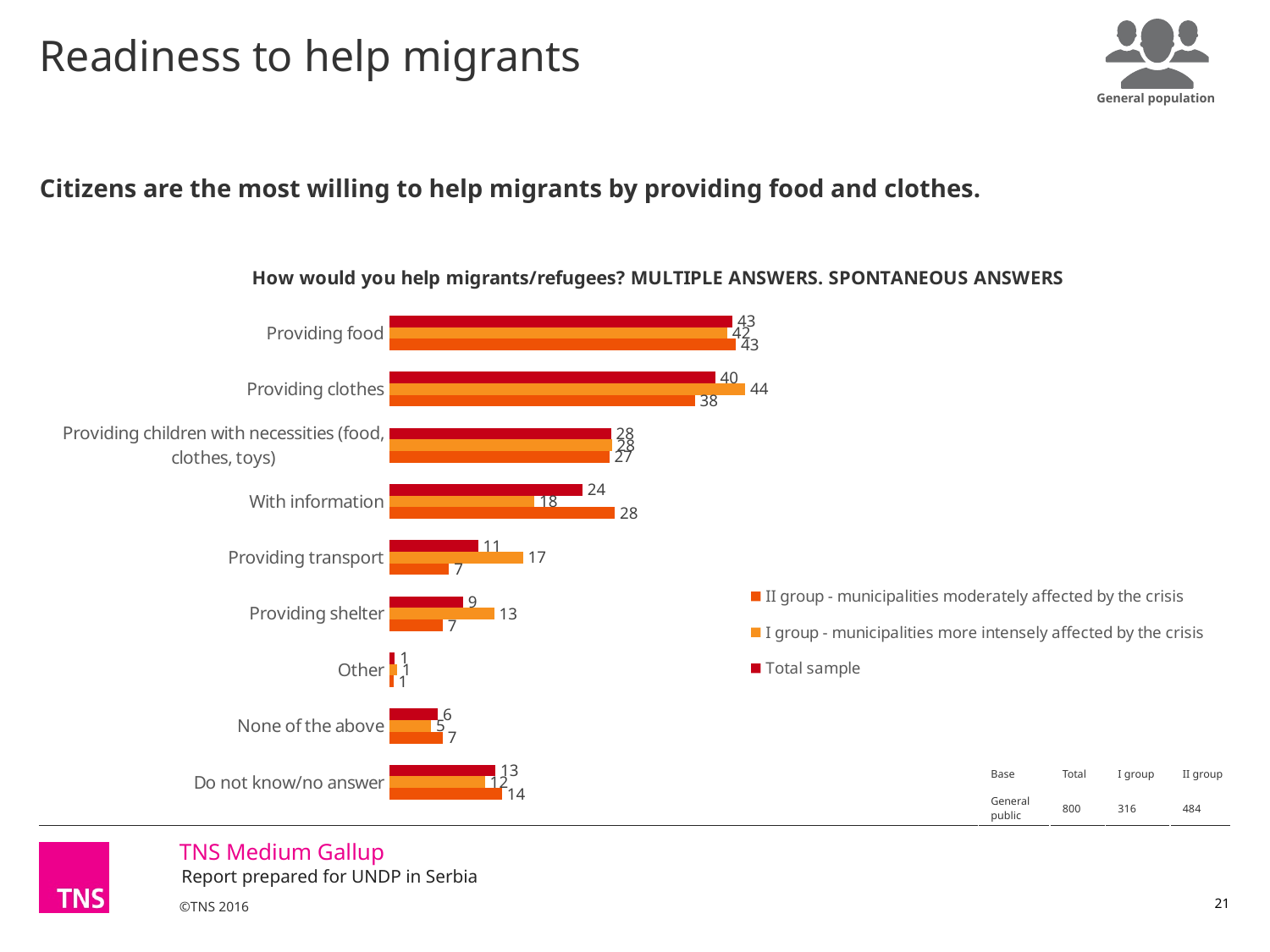
How many series does the legend list? 3 Which category has the highest Total sample value? Providing food What is the value for Providing clothes in the I group (municipalities more intensely affected by the crisis)? 44 How many categories are shown on the chart? 9 What is the I group value for Providing transport? 17 What is the difference between the I group and II group values for Providing transport? 10 For With information, which is larger: the I group value or the II group value? II group What is the Total sample value for Do not know/no answer? 13 Which category has the lowest Total sample value? Other What is the Total sample value for Providing food? 43 What kind of chart is shown on the slide? Bar chart What is the II group value for With information? 28